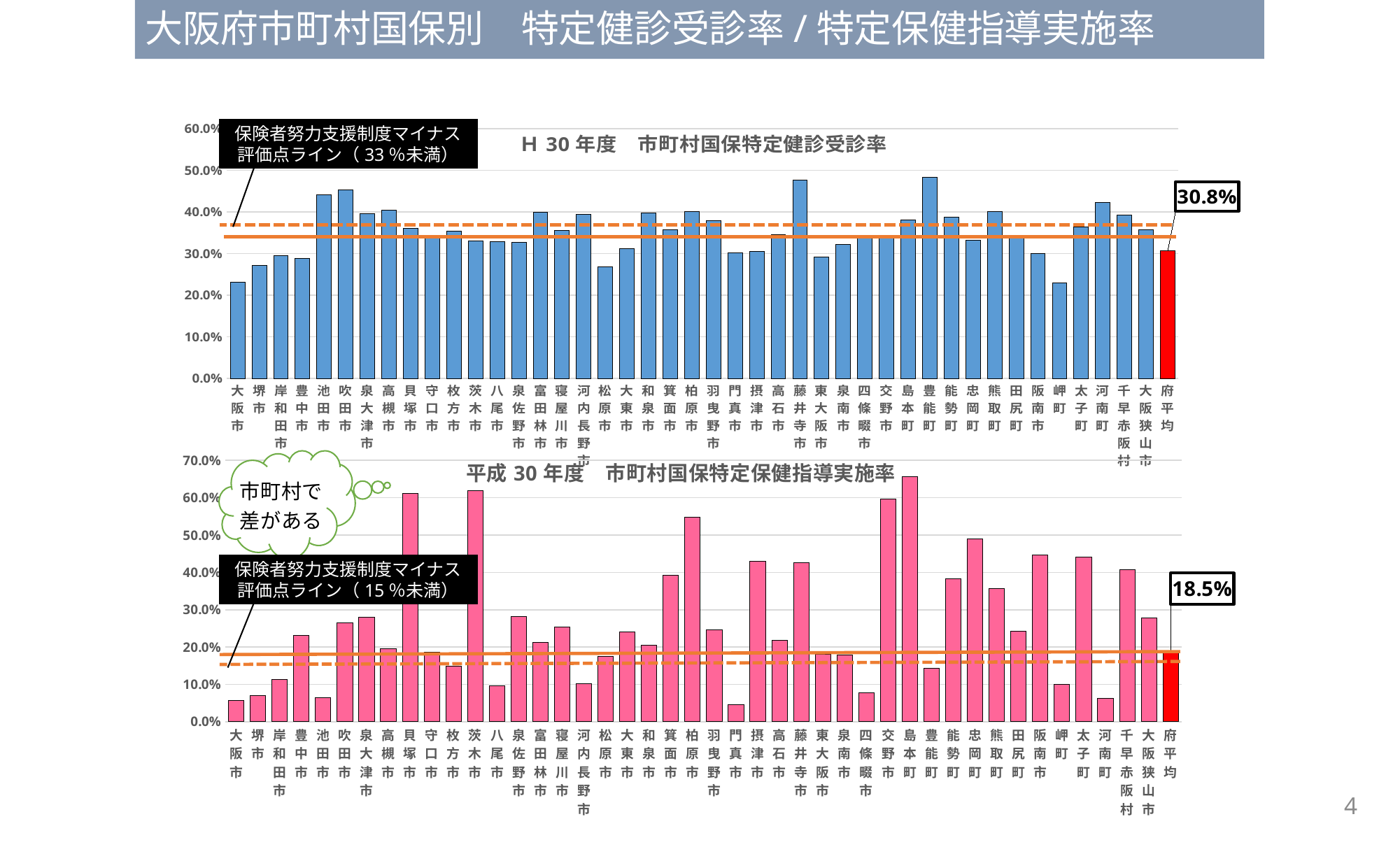
What kind of chart is the top chart (特定健診受診率)? bar chart In the bottom chart (特定保健指導実施率), is the value for 門真市 greater or less than 10.0%? less In the top chart (特定健診受診率), which is larger, the value for 池田市 or the value for 堺市? 池田市 In the bottom chart (特定保健指導実施率), which is larger, the value for 柏原市 or the value for 箕面市? 柏原市 In the bottom chart (特定保健指導実施率), which category has the highest value? 島本町 In the top chart (H30年度 市町村国保特定健診受診率), what is the value for 府平均? 30.8% In the top chart (特定健診受診率), is the value for 大阪市 greater or less than 30.0%? less In the bottom chart (特定保健指導実施率), which category has the lowest value? 門真市 In the top chart (特定健診受診率), is the value for 吹田市 greater or less than 40.0%? greater In the bottom chart (平成30年度 市町村国保特定保健指導実施率), what is the value for 府平均? 18.5% In the top chart (特定健診受診率), what colour is the bar for 府平均? red